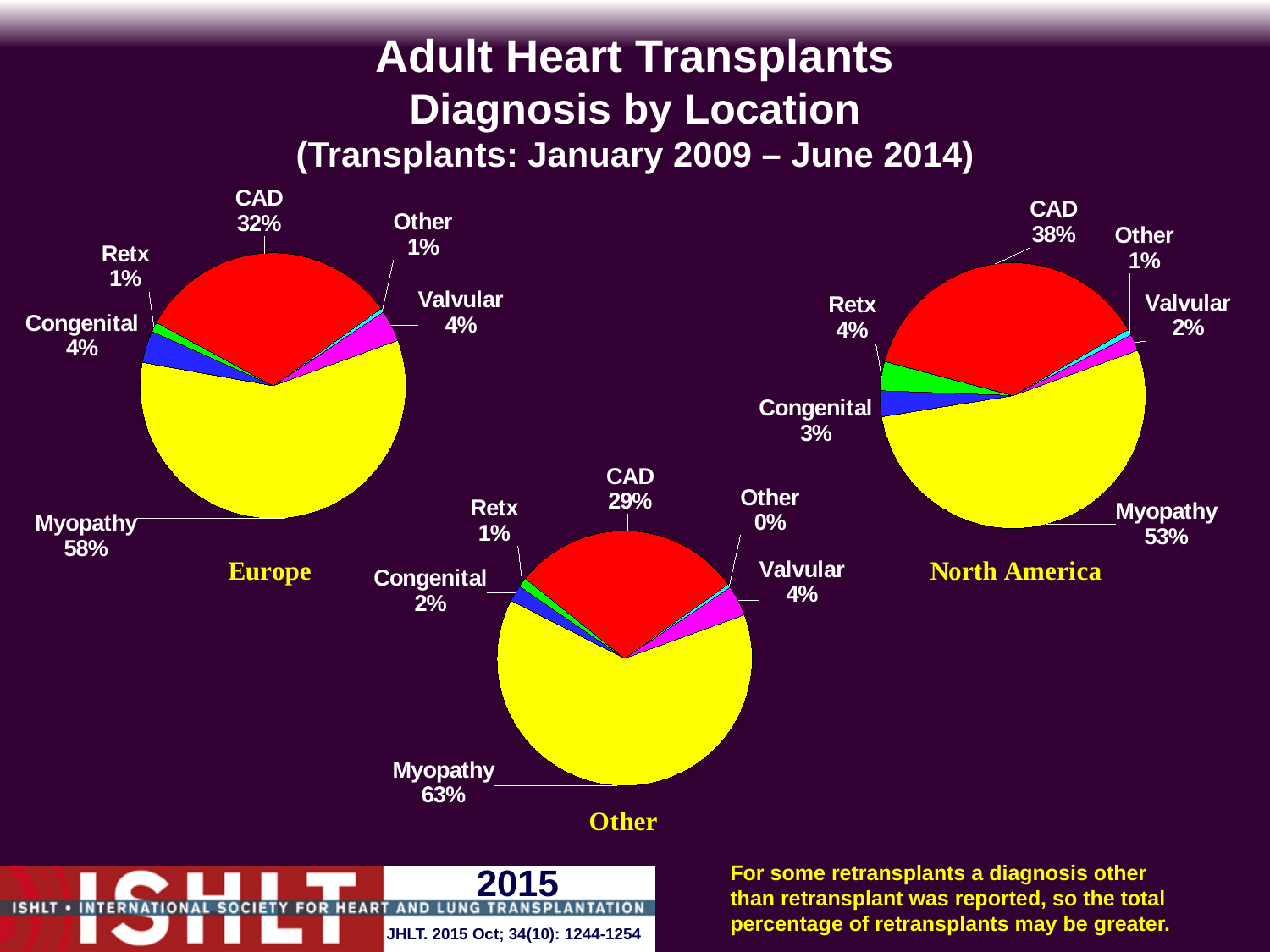
In the Other pie chart, what is the combined share of CAD and Myopathy? 92% In the Europe pie chart, which diagnosis has the largest share? Myopathy In the Other pie chart, what percentage is Myopathy? 63% In the North America pie chart, what percentage is CAD? 38% What type of chart is used to show diagnosis by location on this slide? Pie chart In the Other pie chart, which diagnosis has the smallest share? Other In the North America pie chart, what is the difference between the Myopathy and CAD shares? 15% How many diagnosis categories are shown in the Europe pie chart? 6 In the North America pie chart, what percentage is Retx? 4% In the Europe pie chart, what percentage is Myopathy? 58% Which is larger: the CAD share in North America or the CAD share in Europe? North America How many pie charts are on the slide? 3